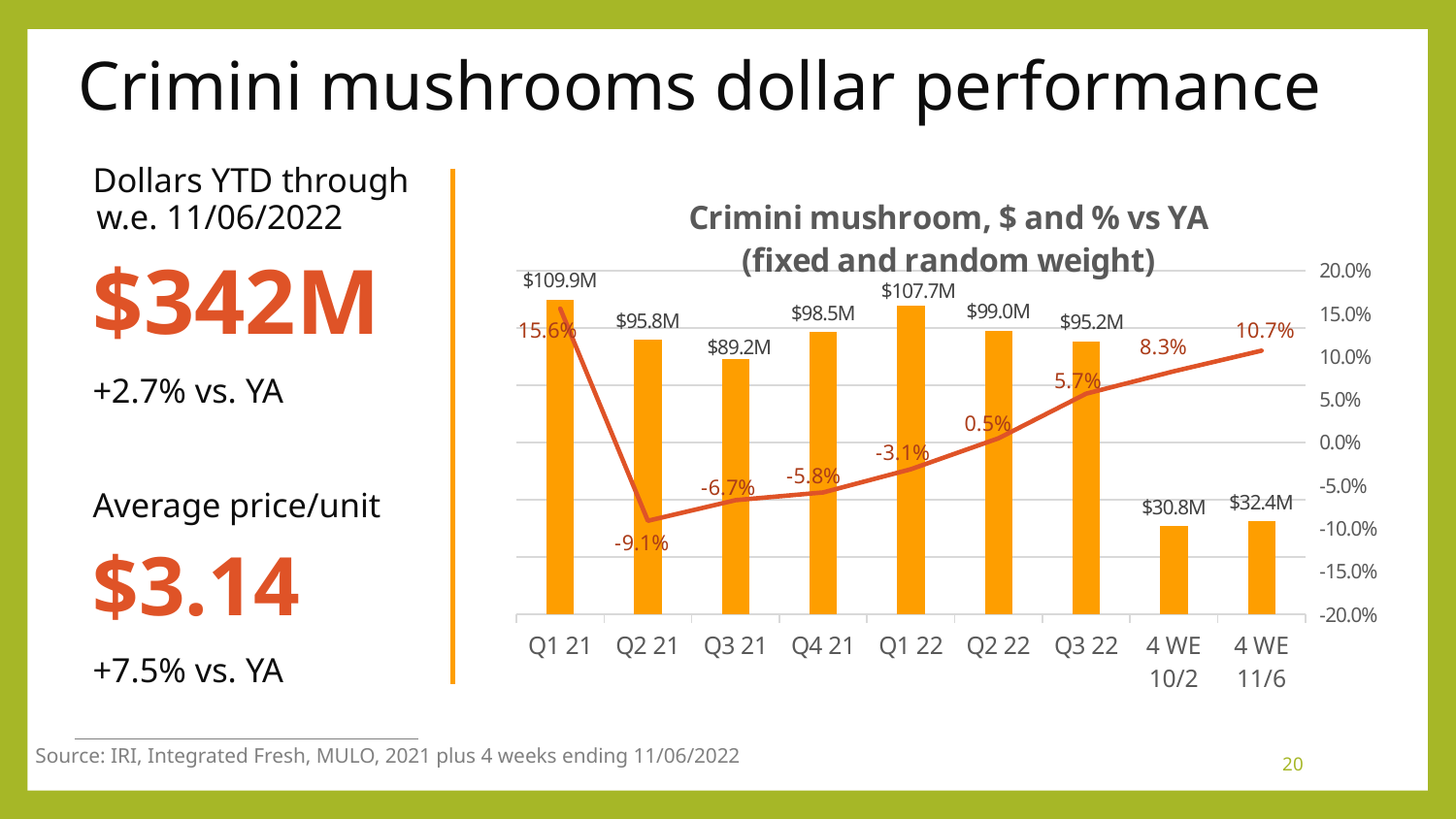
Which has the larger dollar value, Q4 21 or Q2 22? Q2 22 What is the % vs YA value shown for Q3 22? 5.7% What is the difference in dollar value between Q1 22 and Q3 22? $12.5M Which period has the lowest % vs YA value? Q2 21 Which period has the highest dollar value? Q1 21 What is the dollar value shown for the 4 WE 11/6 period? $32.4M What is the % vs YA value shown for Q2 21? -9.1% How many periods are shown on the x axis? 9 Does the % vs YA line rise or fall from Q2 21 to 4 WE 11/6? Rise What is the dollar value shown for Q1 21? $109.9M What kind of chart is this? Combined bar and line chart What is the title of the chart? Crimini mushroom, $ and % vs YA (fixed and random weight)